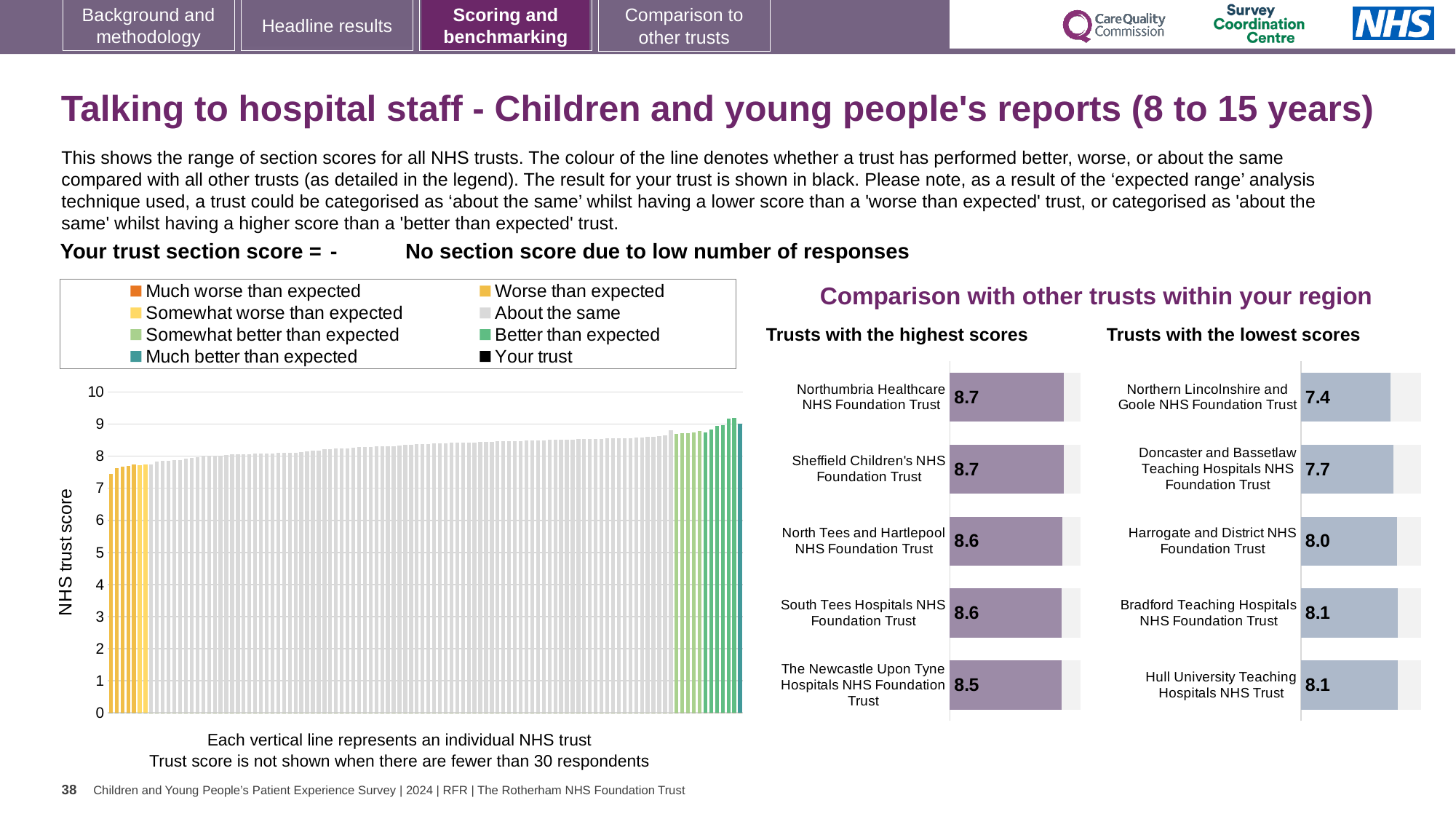
In the 'Trusts with the lowest scores' chart, which trust has the lowest score? Northern Lincolnshire and Goole NHS Foundation Trust In the 'Trusts with the lowest scores' chart, what is the score for Northern Lincolnshire and Goole NHS Foundation Trust? 7.4 In the 'Trusts with the lowest scores' chart, what is the score for Harrogate and District NHS Foundation Trust? 8.0 How many trusts are listed in the 'Trusts with the highest scores' chart? 5 In the 'Trusts with the lowest scores' chart, which has the larger score: Doncaster and Bassetlaw Teaching Hospitals NHS Foundation Trust or Harrogate and District NHS Foundation Trust? Harrogate and District NHS Foundation Trust What kind of chart is the large chart on the left showing NHS trust scores? Bar chart In the large chart on the left, is the value of the leftmost bar greater or less than 8? less In the 'Trusts with the highest scores' chart, which trust has the lowest score? The Newcastle Upon Tyne Hospitals NHS Foundation Trust In the 'Trusts with the highest scores' chart, what is the score for The Newcastle Upon Tyne Hospitals NHS Foundation Trust? 8.5 In the 'Trusts with the lowest scores' chart, what is the difference between the scores of Harrogate and District NHS Foundation Trust and Northern Lincolnshire and Goole NHS Foundation Trust? 0.6 In the large chart on the left, do the NHS trust scores rise or fall from left to right? Rise In the 'Trusts with the highest scores' chart, what is the score for Northumbria Healthcare NHS Foundation Trust? 8.7